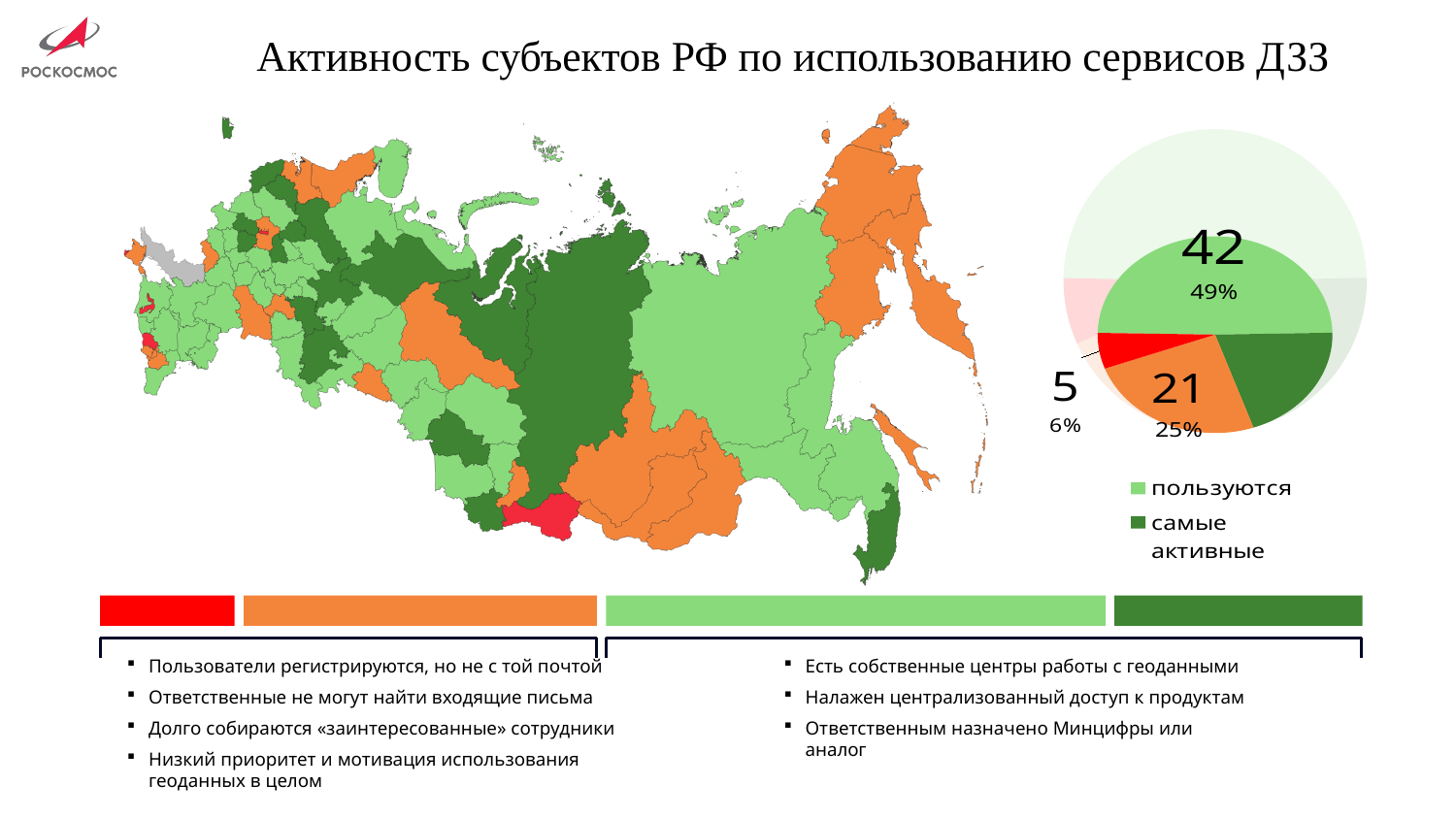
What is the title of the slide containing the pie chart? Активность субъектов РФ по использованию сервисов ДЗЗ In the pie chart, what value is shown for the orange slice? 21 In the pie chart, what value is shown for the red slice? 5 In the pie chart, what percentage share is shown for the slice labelled 21? 25% In the pie chart, what percentage share is shown for the slice labelled 42? 49% In the pie chart, which is larger: the slice labelled 21 or the slice labelled 5? 21 In the pie chart, what percentage share is shown for the red slice? 6% In the pie chart, what is the difference between the slice labelled 42 and the slice labelled 21? 21 How many slices does the pie chart have? 4 In the pie chart, what value is shown for the largest slice? 42 In the pie chart, which labelled slice has the smallest value? 5 (6%) What kind of chart is shown on the right side of the slide? pie chart